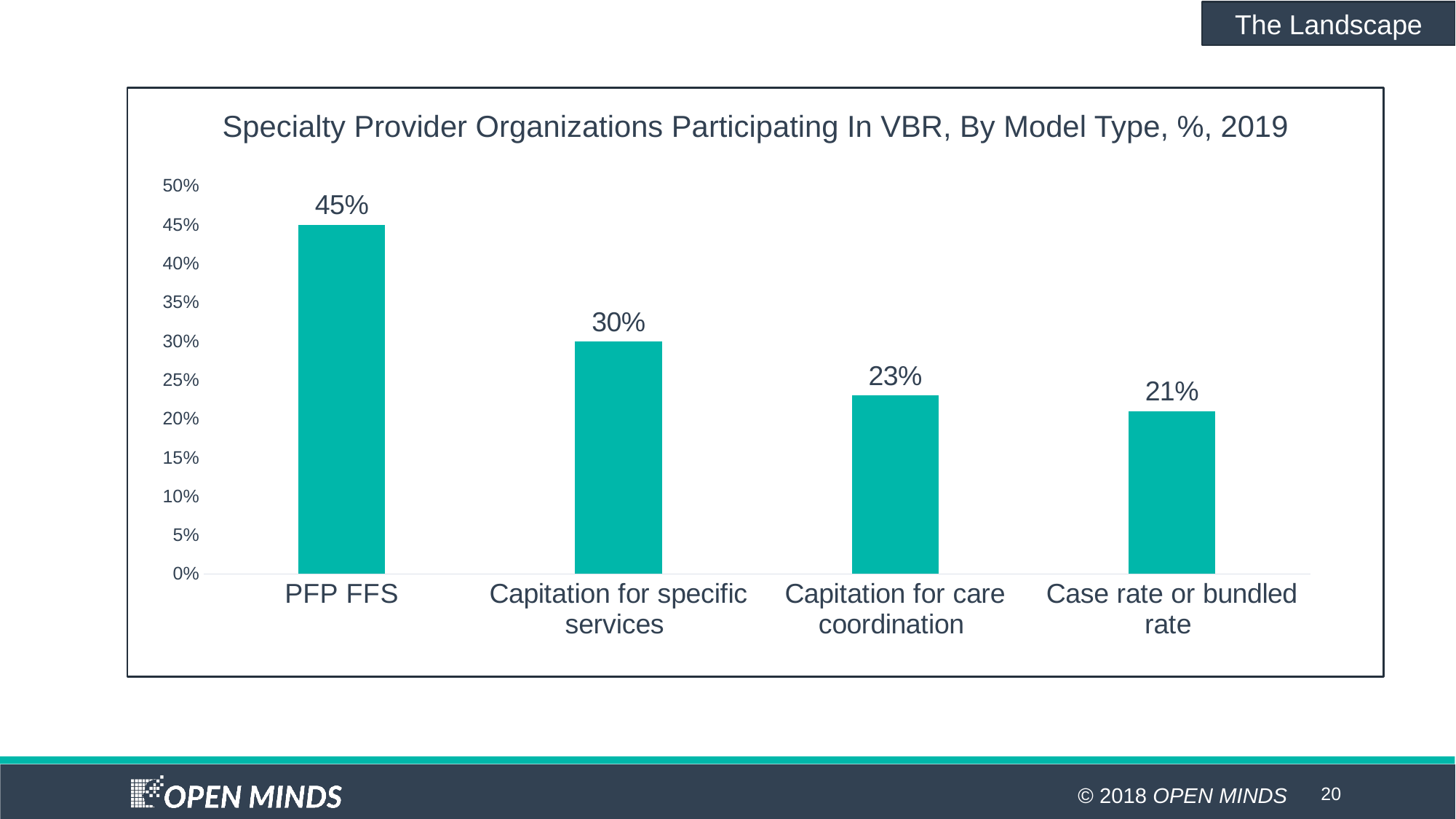
What percentage of specialty provider organizations participate in PFP FFS? 45% What is the difference between the values for PFP FFS and Capitation for specific services? 15% Which model type has the highest participation percentage? PFP FFS What kind of chart is shown on the slide? Bar chart What is the difference between the values for Capitation for care coordination and Case rate or bundled rate? 2% What is the value for Capitation for care coordination? 23% Which is larger, the value for Capitation for specific services or the value for Capitation for care coordination? Capitation for specific services What is the value for Case rate or bundled rate? 21% Which model type has the lowest participation percentage? Case rate or bundled rate What is the value for Capitation for specific services? 30% How many model types are shown in the chart? 4 Do the values rise or fall from left to right across the x axis? Fall